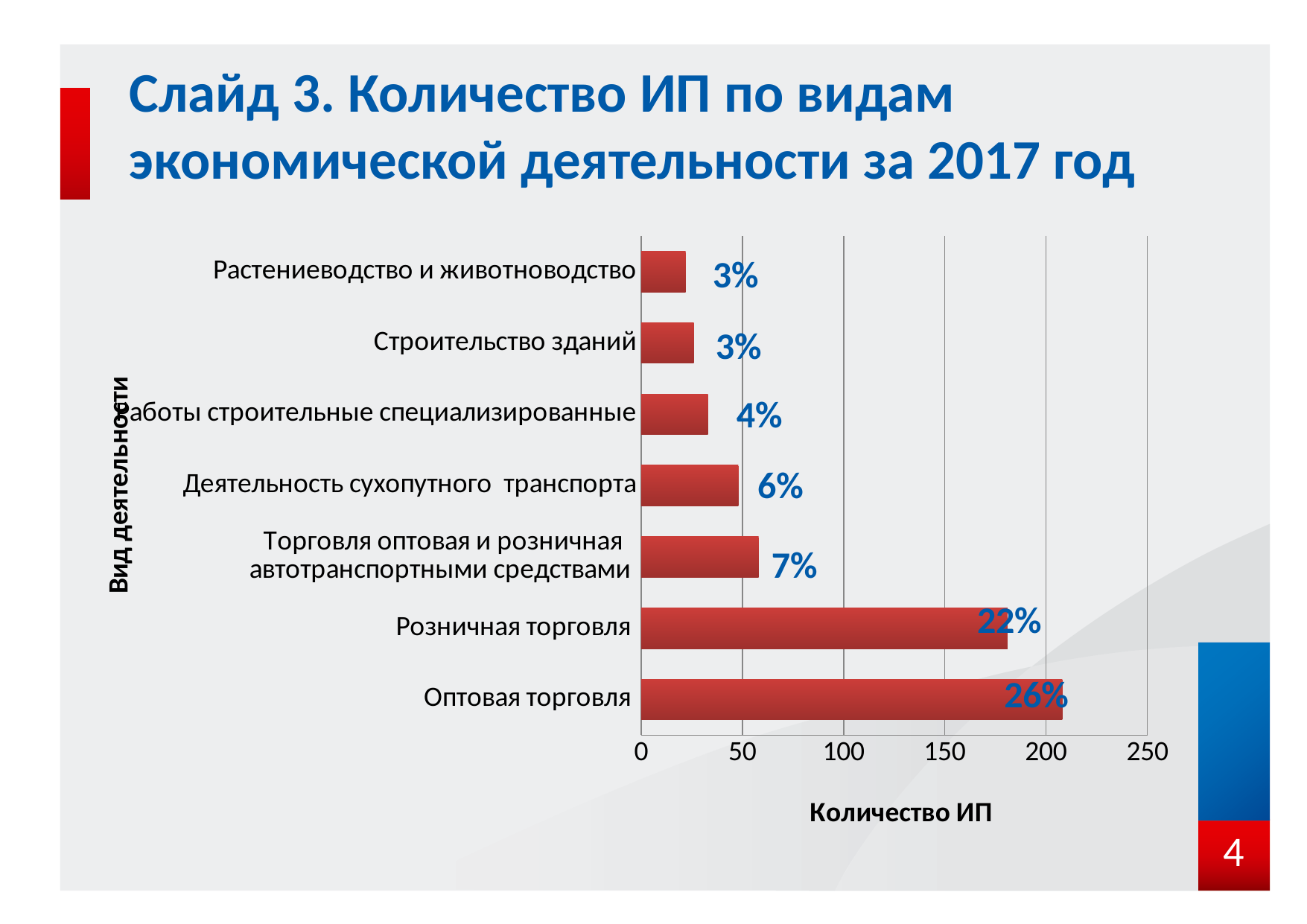
What percentage label is shown for Деятельность сухопутного транспорта? 6% Which is larger: the value for Розничная торговля or for Деятельность сухопутного транспорта? Розничная торговля Is the value for Розничная торговля greater or less than 150? greater What kind of chart is shown on the slide? Bar chart How many types of economic activity are shown in the chart? 7 What percentage label is shown for Розничная торговля? 22% What percentage label is shown for Торговля оптовая и розничная автотранспортными средствами? 7% Which type of activity has the highest number of ИП? Оптовая торговля Is the value for Строительство зданий greater or less than 50? less By how many percentage points does the label for Оптовая торговля exceed the label for Розничная торговля? 4 percentage points What percentage label is shown for Оптовая торговля? 26% Is the value for Оптовая торговля greater or less than 200? greater